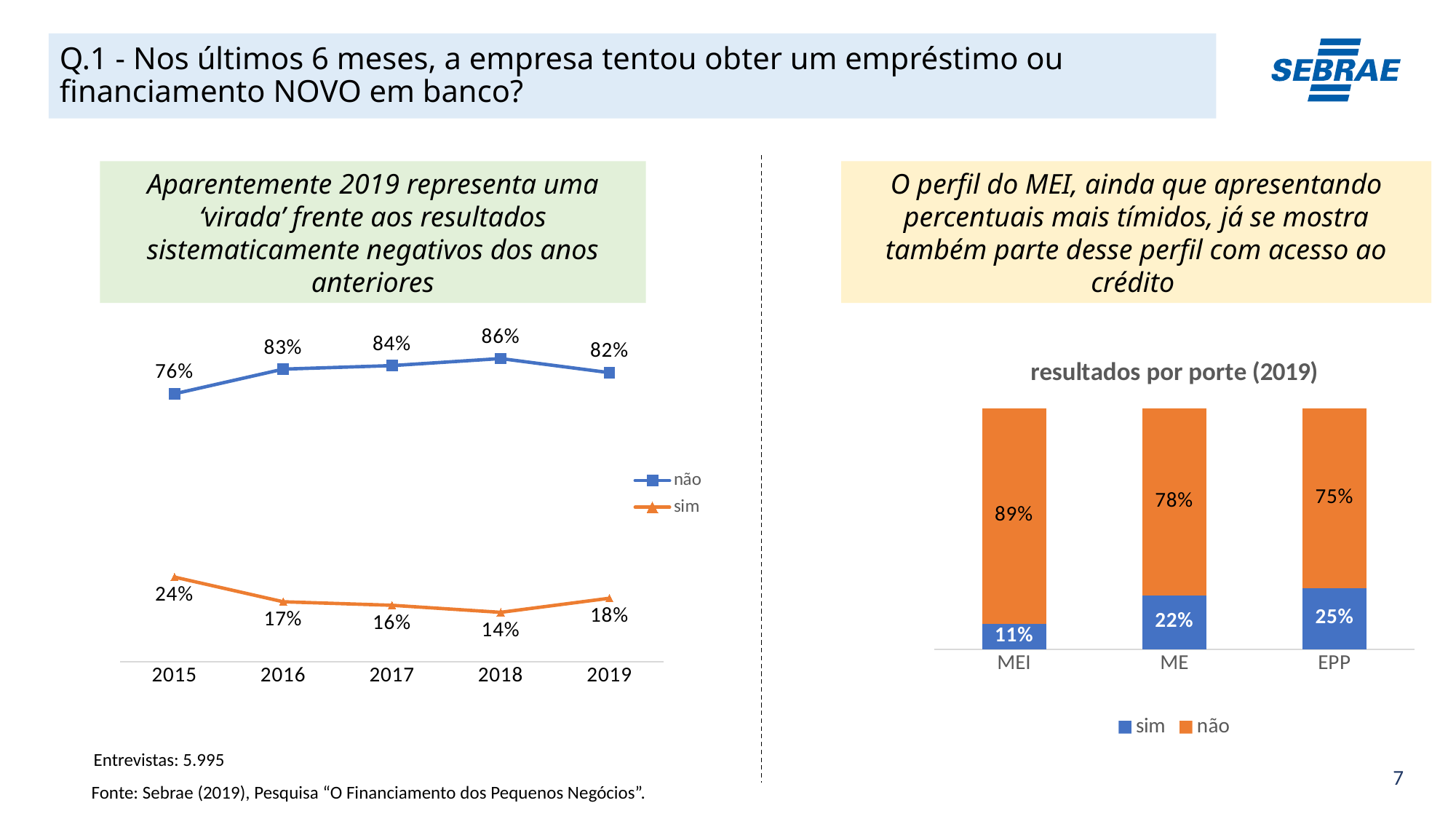
In the line chart on the left, which year has the highest value for 'não'? 2018 In the chart titled 'resultados por porte (2019)', what is the total of the stacked bar for EPP? 100% In the line chart on the left, does the 'sim' line rise or fall from 2015 to 2018? fall What kind of chart is 'resultados por porte (2019)'? stacked bar chart In the line chart on the left, how many years are shown on the x axis? 5 In the line chart on the left, what is the difference between the 'sim' values for 2019 and 2018? 4% In the chart titled 'resultados por porte (2019)', is the 'sim' value larger for MEI or for EPP? EPP In the chart titled 'resultados por porte (2019)', what is the 'sim' value for ME? 22% In the chart titled 'resultados por porte (2019)', which category has the highest 'não' value? MEI In the line chart on the left, what is the value for 'não' in 2018? 86% In the line chart on the left, which year has the lowest value for 'sim'? 2018 In the line chart on the left, what is the value for 'sim' in 2015? 24%